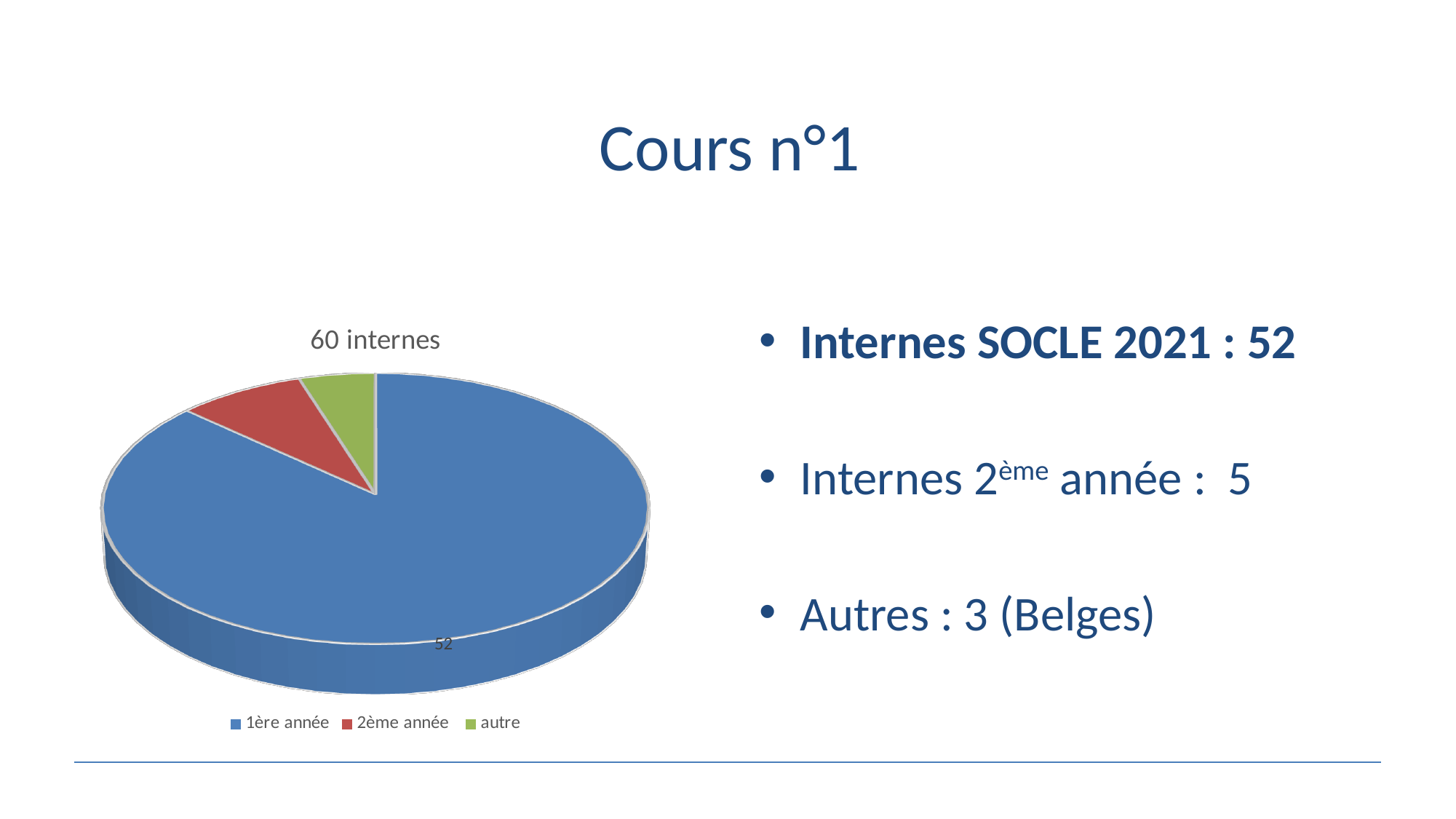
Which slice is larger in the pie chart, 1ère année or 2ème année? 1ère année How many slices does the pie chart have? 3 Which category has the smallest slice in the pie chart? autre How many entries does the legend of the pie chart list? 3 Which slice is larger in the pie chart, 2ème année or autre? 2ème année What is the title of the pie chart? 60 internes What colour is the 1ère année slice in the pie chart? blue What kind of chart is shown on the slide? pie chart Which category has the largest slice in the pie chart? 1ère année What value is labelled on the 1ère année slice of the pie chart? 52